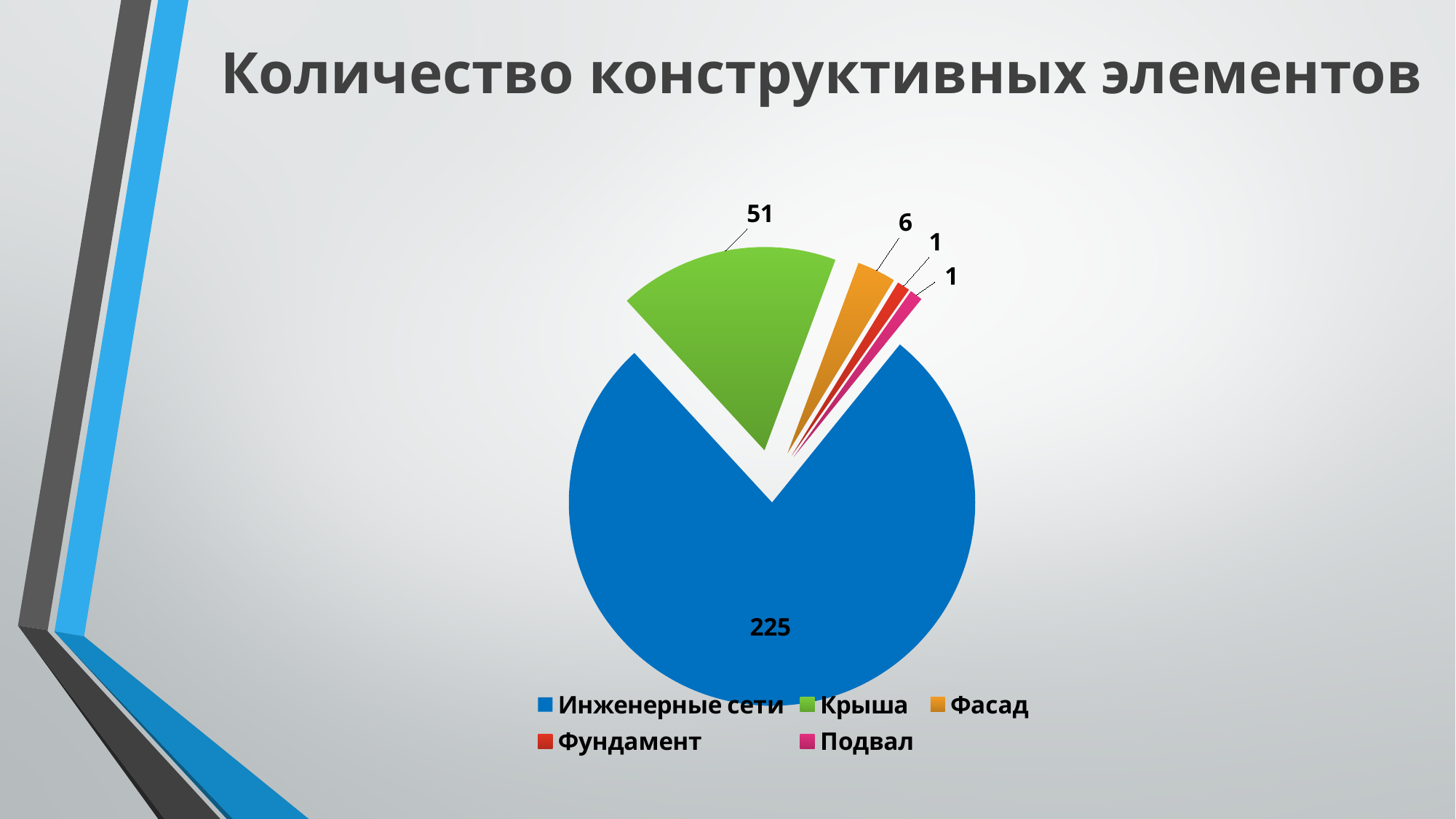
Which category has the highest value? Инженерные сети What kind of chart is shown on the slide? Pie chart What is the difference between the values for Инженерные сети and Крыша? 174 What is the value for Инженерные сети? 225 What is the value for Фасад? 6 Which is larger, the value for Крыша or the value for Фасад? Крыша What is the total of all the slices in the pie chart? 284 What is the value for Крыша? 51 How many categories does the pie chart have? 5 What is the difference between the values for Крыша and Фасад? 45 What is the title of the chart? Количество конструктивных элементов What is the value for Фундамент? 1